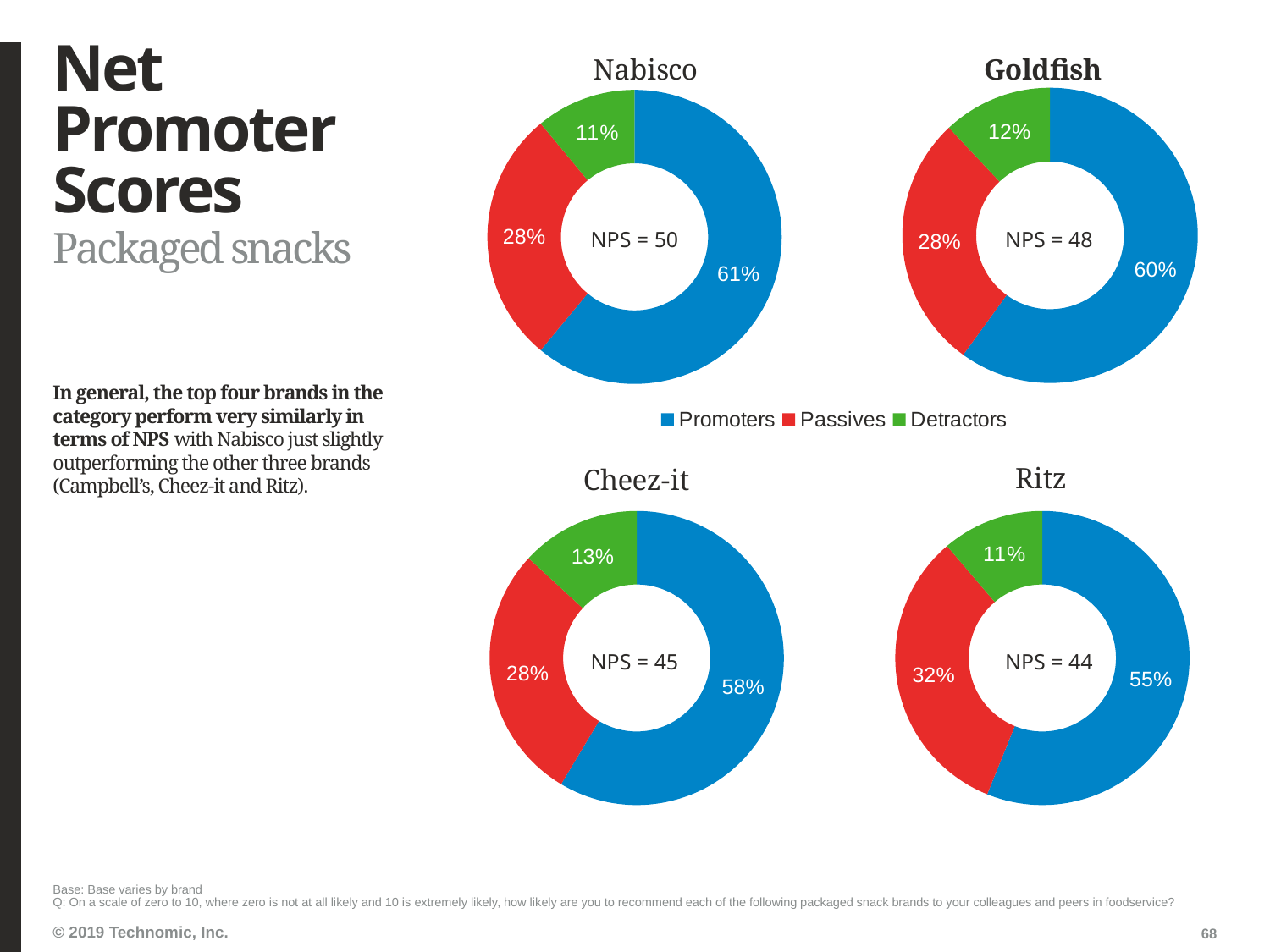
Which colour represents Passives in the legend? Red Which is larger: the Promoters share in the Nabisco chart or the Promoters share in the Ritz chart? Nabisco In the Nabisco chart, what is the difference between the Promoters and Passives percentages? 33% In the Nabisco chart, what percentage are Promoters? 61% In the Goldfish chart, what percentage are Detractors? 12% In the Cheez-it chart, which segment is the largest? Promoters In the Ritz chart, what percentage are Passives? 32% In the Cheez-it chart, what is the NPS shown in the centre? NPS = 45 How many segments does the Goldfish chart have? 3 What kind of chart is the Nabisco chart? Doughnut chart In the Ritz chart, which segment is the smallest? Detractors How many series does the shared legend list? 3